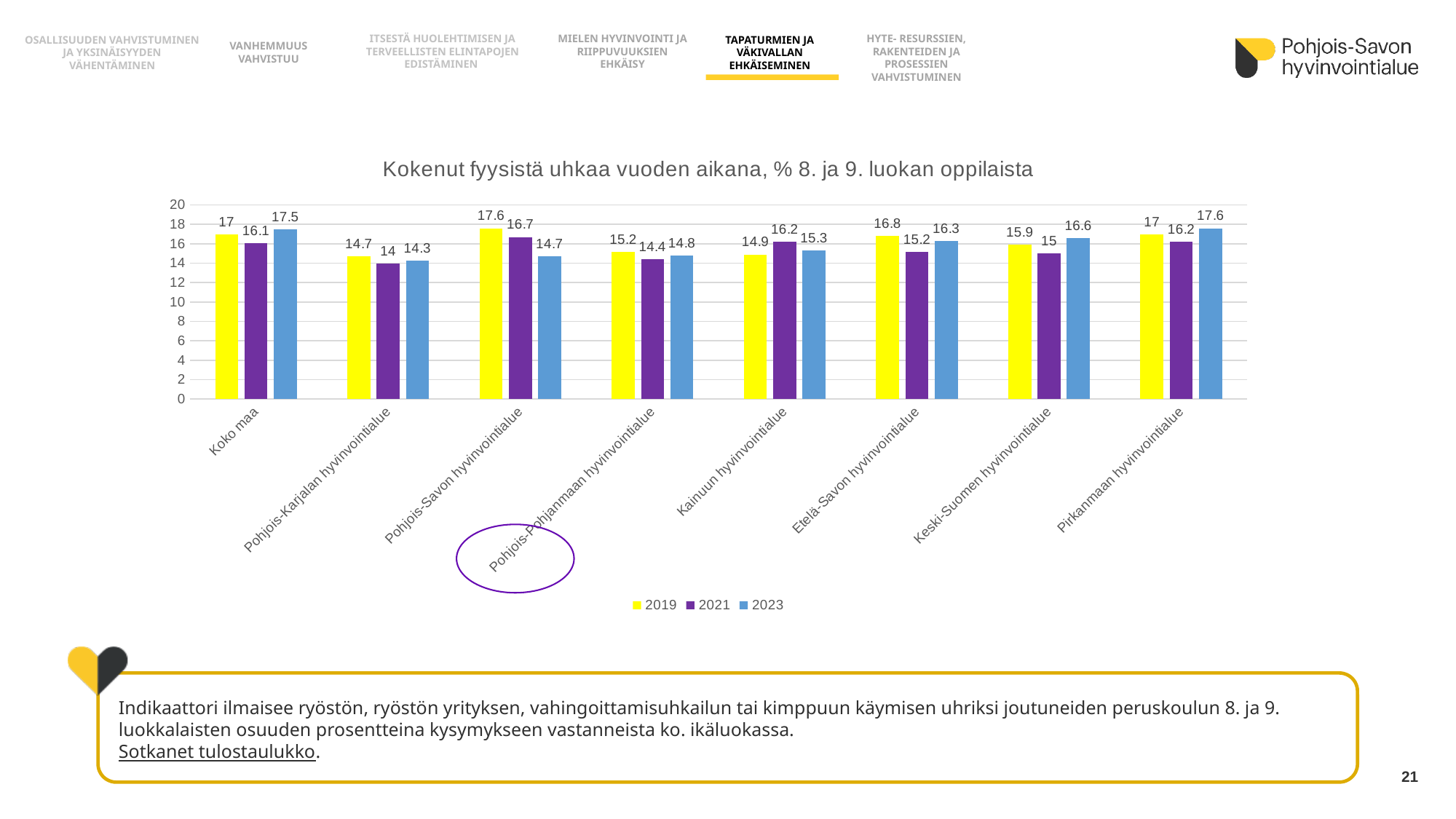
What is the 2023 value for Pohjois-Savon hyvinvointialue? 14.7 What is the 2019 value for Etelä-Savon hyvinvointialue? 16.8 What is the 2021 value for Koko maa? 16.1 How many series does the legend list? 3 Which area has the highest 2019 value? Pohjois-Savon hyvinvointialue What is the title of the chart? Kokenut fyysistä uhkaa vuoden aikana, % 8. ja 9. luokan oppilaista Which area has the lowest 2021 value? Pohjois-Karjalan hyvinvointialue What is the difference between the 2019 and 2023 values for Pohjois-Savon hyvinvointialue? 2.9 Do the values for Pohjois-Savon hyvinvointialue rise or fall from 2019 to 2023? fall What type of chart is shown on the slide? bar chart How many categories (areas) are shown on the x axis? 8 Which is larger for Kainuun hyvinvointialue, the 2019 value or the 2021 value? 2021